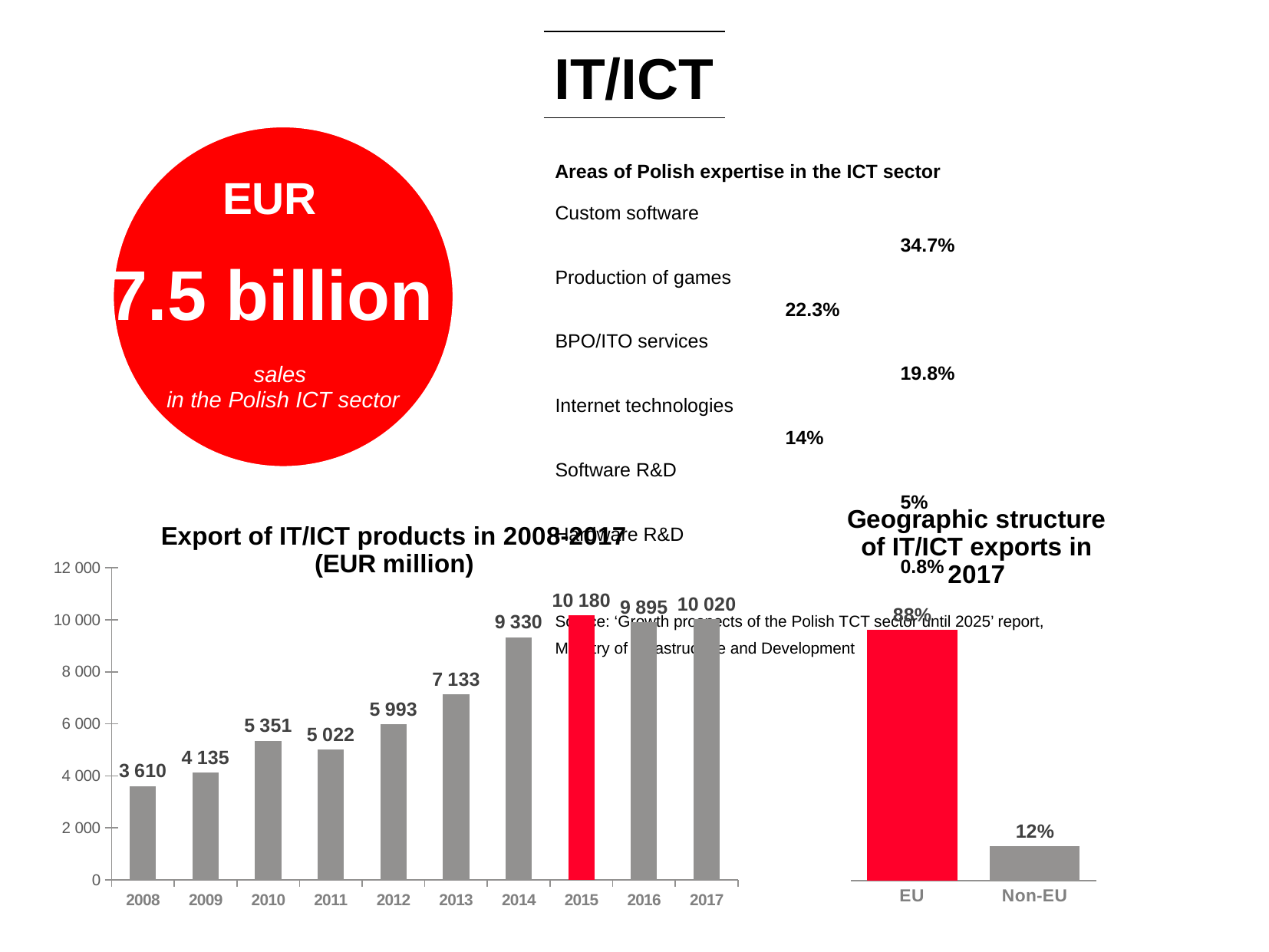
In the 'Export of IT/ICT products in 2008-2017' chart, what is the difference between the 2017 and 2016 values? 125 In the 'Export of IT/ICT products in 2008-2017' chart, which year has the larger value, 2010 or 2011? 2010 In the 'Export of IT/ICT products in 2008-2017' chart, which year has the highest export value? 2015 What kind of chart is 'Export of IT/ICT products in 2008-2017'? Bar chart In the 'Export of IT/ICT products in 2008-2017' chart, which bar is highlighted in red? 2015 In the 'Geographic structure of IT/ICT exports in 2017' chart, what is the difference between the EU and Non-EU shares? 76% In the 'Export of IT/ICT products in 2008-2017' chart, which year has the lowest export value? 2008 In the 'Geographic structure of IT/ICT exports in 2017' chart, what share of exports goes to the EU? 88% In the 'Export of IT/ICT products in 2008-2017' chart, what was the export value in 2014? 9 330 In the 'Geographic structure of IT/ICT exports in 2017' chart, what share of exports goes to Non-EU countries? 12% In the 'Export of IT/ICT products in 2008-2017' chart, how many years are shown on the x axis? 10 In the 'Export of IT/ICT products in 2008-2017' chart, what was the export value in 2008? 3 610